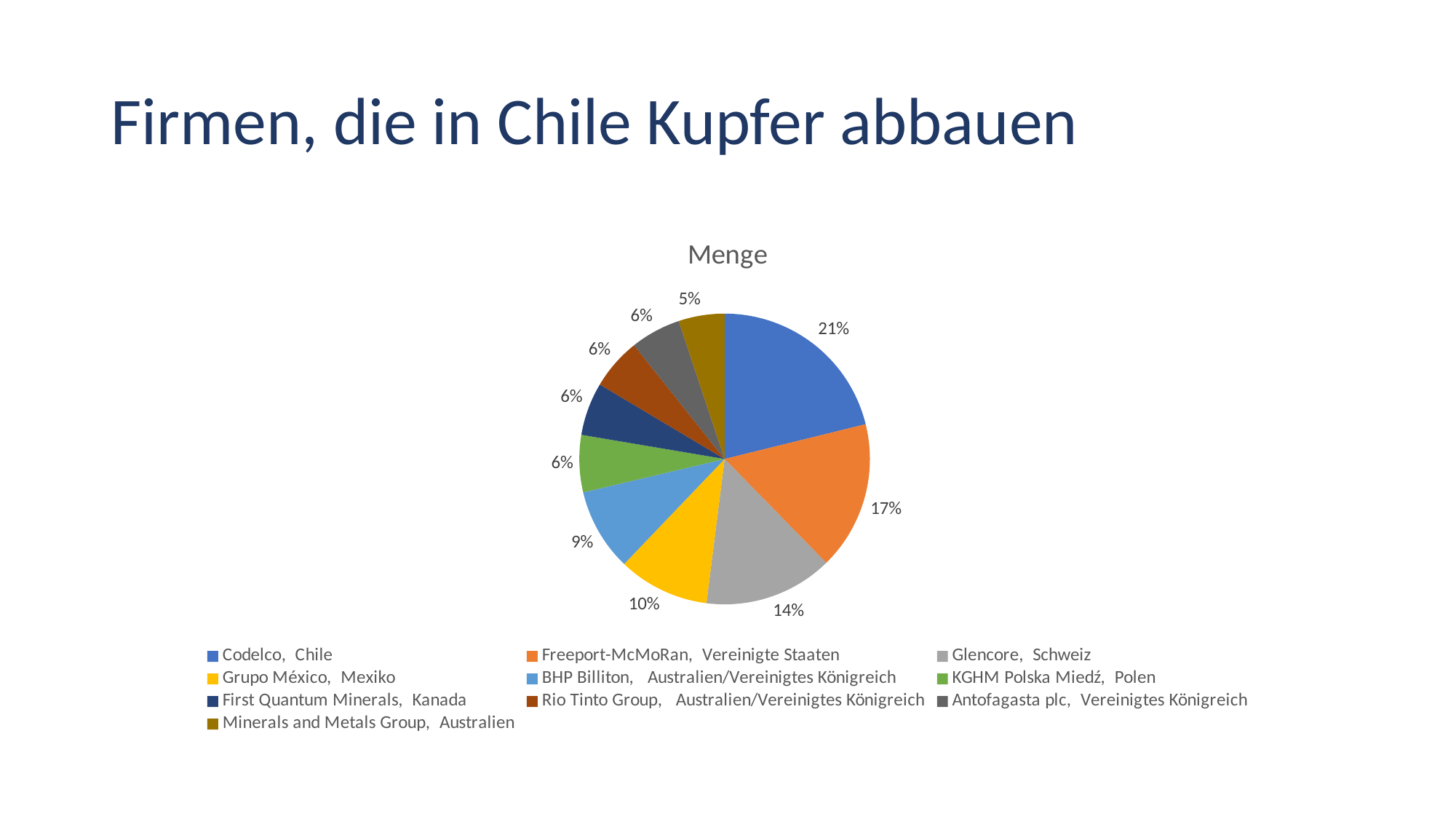
Which has a larger share, Grupo México, Mexiko or BHP Billiton, Australien/Vereinigtes Königreich? Grupo México, Mexiko Which company has the largest slice of the pie? Codelco, Chile What share of the pie does BHP Billiton, Australien/Vereinigtes Königreich have? 9% Which company has the smallest slice of the pie? Minerals and Metals Group, Australien What share of the pie does Freeport-McMoRan, Vereinigte Staaten have? 17% What share of the pie does Glencore, Schweiz have? 14% What is the difference in percentage points between Codelco, Chile and Glencore, Schweiz? 7 How many companies are shown in the pie chart? 10 What is the chart's title? Menge What kind of chart is shown on the slide? pie chart